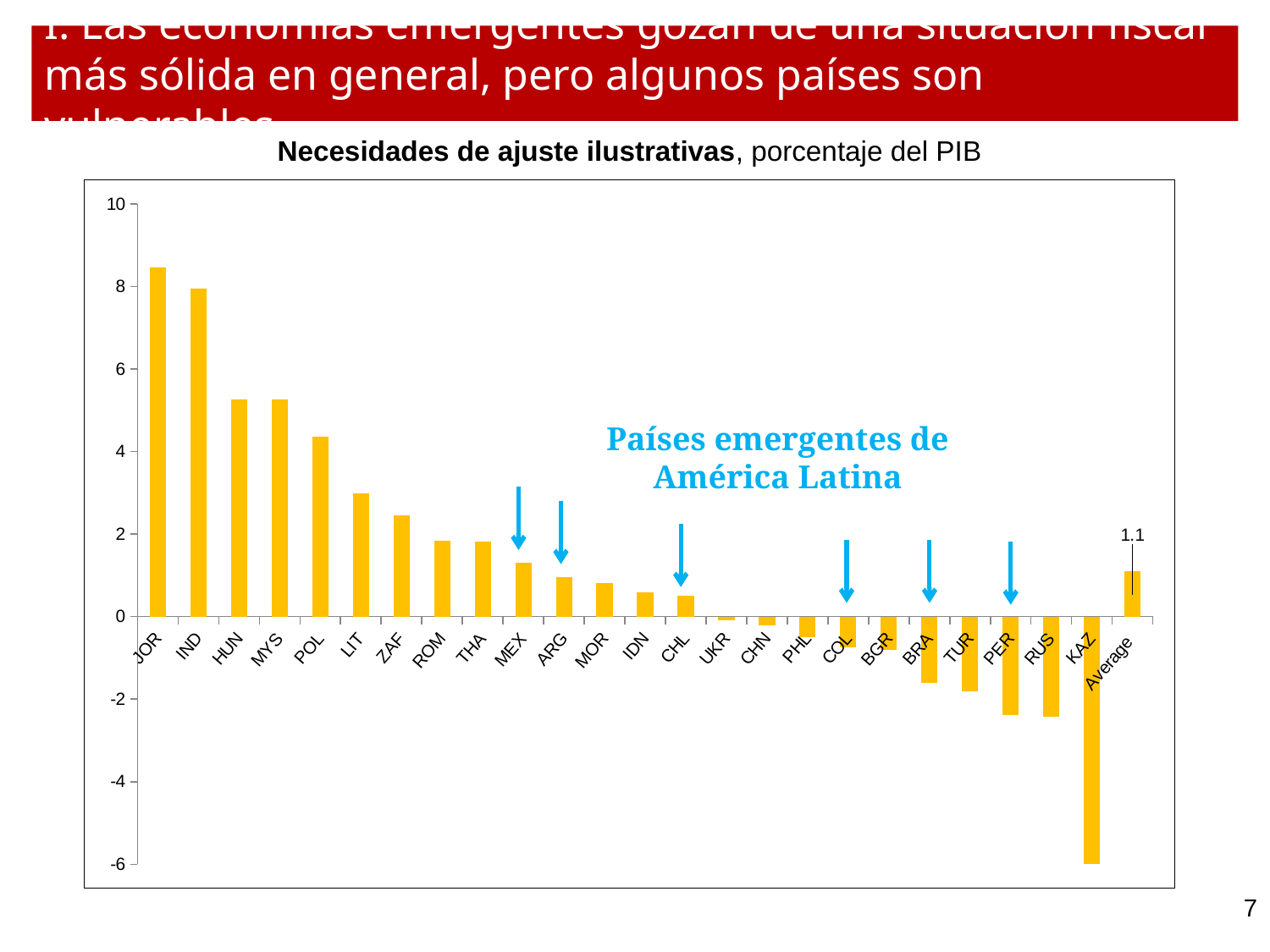
Which has the larger value, MEX or BRA? MEX What value is printed for the Average bar? 1.1 Is the value for JOR greater or less than 8? greater Which has the larger value, JOR or IND? JOR Is the value for POL greater or less than 4? greater Do the country values rise or fall from left to right along the x axis (before the Average bar)? Fall What kind of chart is shown on the slide? Bar chart How many bars (categories) are shown on the x axis, including Average? 25 Which country has the lowest value in the chart? KAZ Is the value for KAZ greater or less than -4? less Which country has the highest value in the chart? JOR